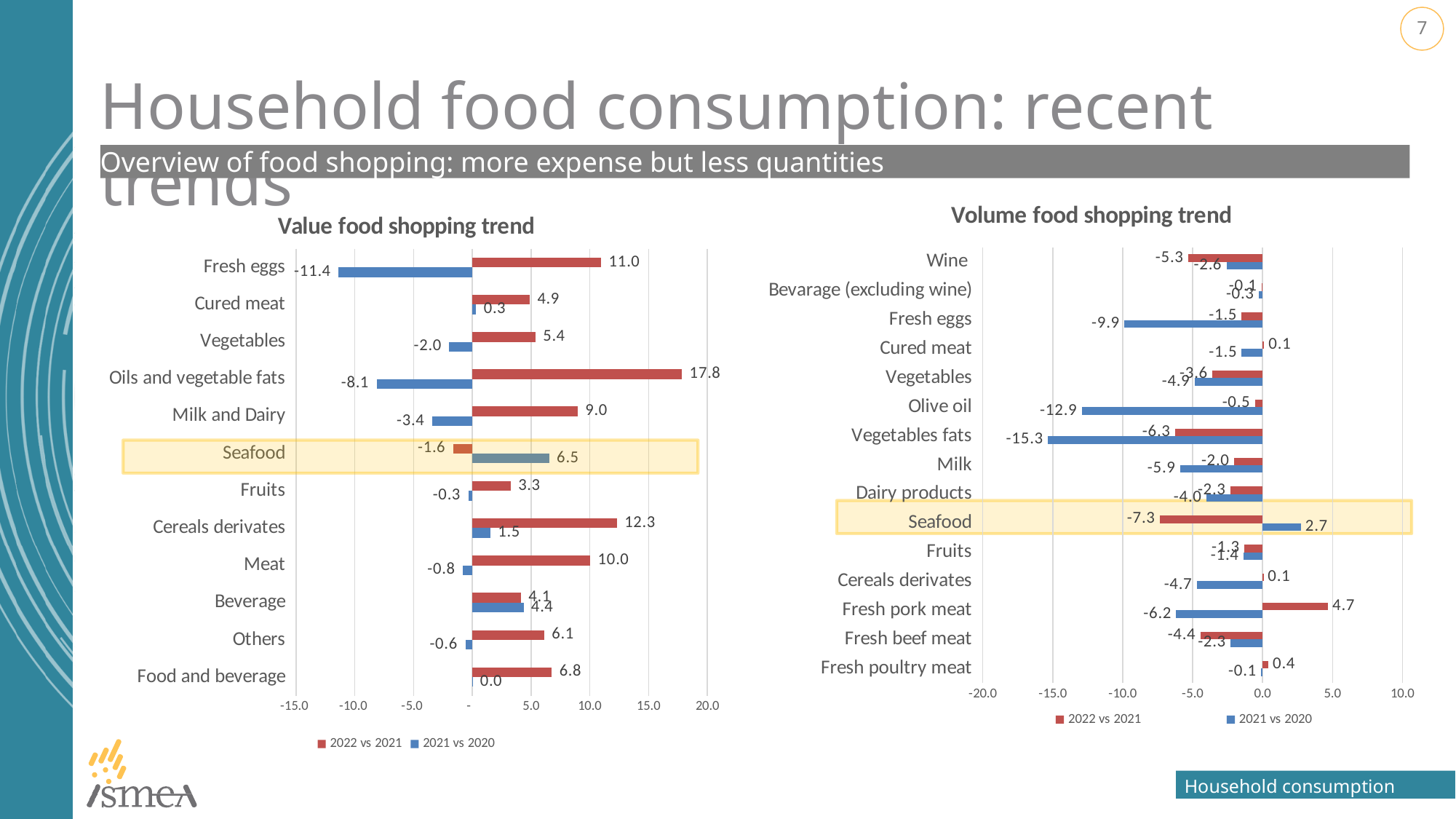
In the Value food shopping trend chart, how many categories are shown? 12 In the Volume food shopping trend chart, how many categories are shown? 15 In the Value food shopping trend chart, what is the 2021 vs 2020 value for Fresh eggs? -11.4 In the Value food shopping trend chart, what is the 2022 vs 2021 value for Oils and vegetable fats? 17.8 In the Value food shopping trend chart, which category has the highest 2022 vs 2021 value? Oils and vegetable fats In the Value food shopping trend chart, which category has the lowest 2021 vs 2020 value? Fresh eggs In the Volume food shopping trend chart, which category has the highest 2022 vs 2021 value? Fresh pork meat In the Volume food shopping trend chart, which is larger for Olive oil: the 2022 vs 2021 value or the 2021 vs 2020 value? 2022 vs 2021 What type of chart is the Volume food shopping trend chart? Bar chart In the Value food shopping trend chart, what is the difference between the 2022 vs 2021 values for Cereals derivates and Meat? 2.3 In the Volume food shopping trend chart, what is the 2022 vs 2021 value for Seafood? -7.3 In the Volume food shopping trend chart, what is the 2021 vs 2020 value for Vegetables fats? -15.3